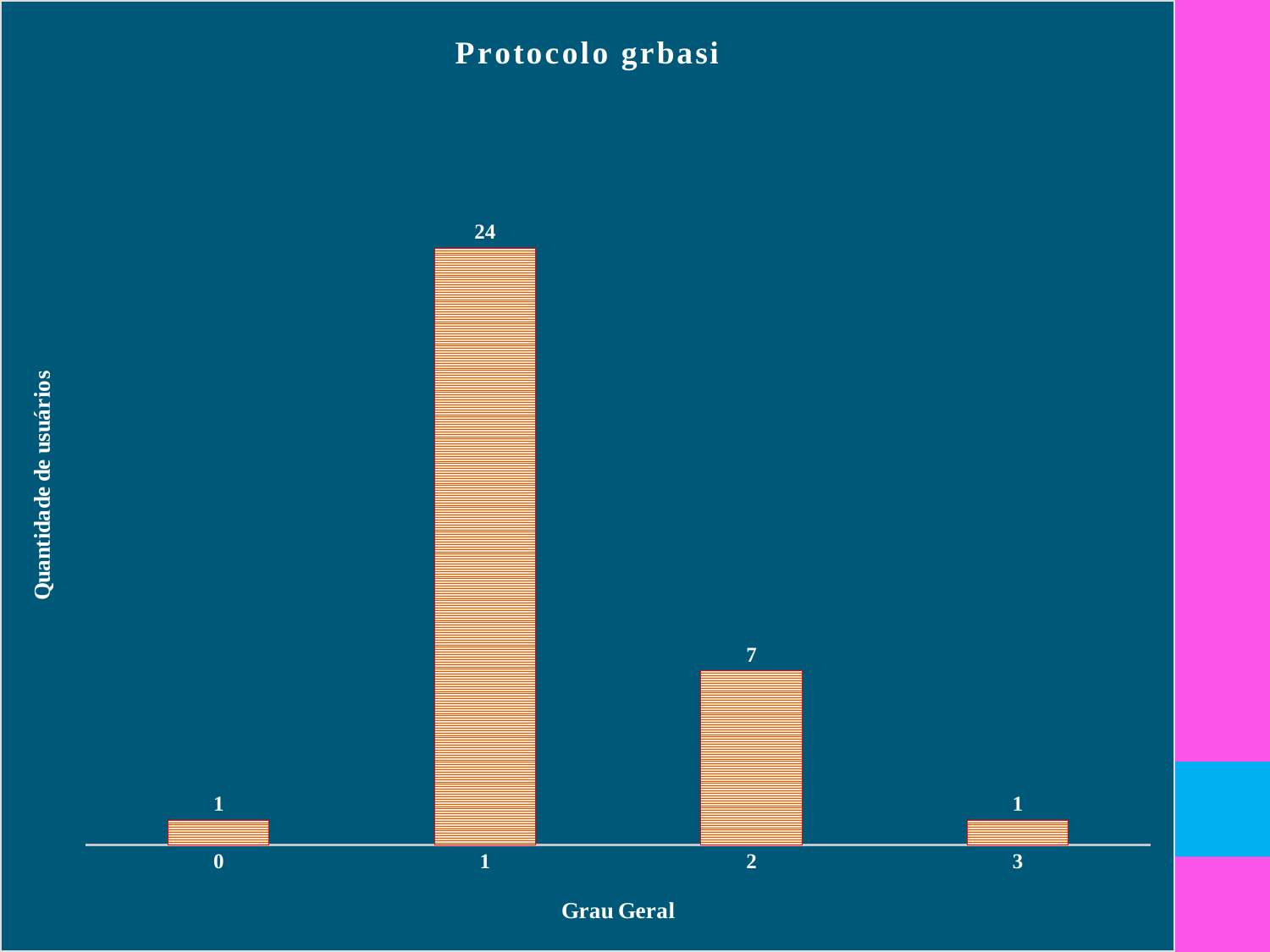
What is the title of the chart? Protocolo grbasi Which is larger, the value for Grau Geral 2 or Grau Geral 3? Grau Geral 2 What is the value for Grau Geral 1? 24 Which Grau Geral category has the highest number of users? 1 What is the difference between the values for Grau Geral 2 and Grau Geral 0? 6 Which two Grau Geral categories share the lowest value? 0 and 3 What kind of chart is shown on the slide? Bar chart What is the label of the y axis? Quantidade de usuários How many categories are shown on the x axis? 4 What is the value for Grau Geral 2? 7 What is the value for Grau Geral 0? 1 What is the difference between the values for Grau Geral 1 and Grau Geral 2? 17